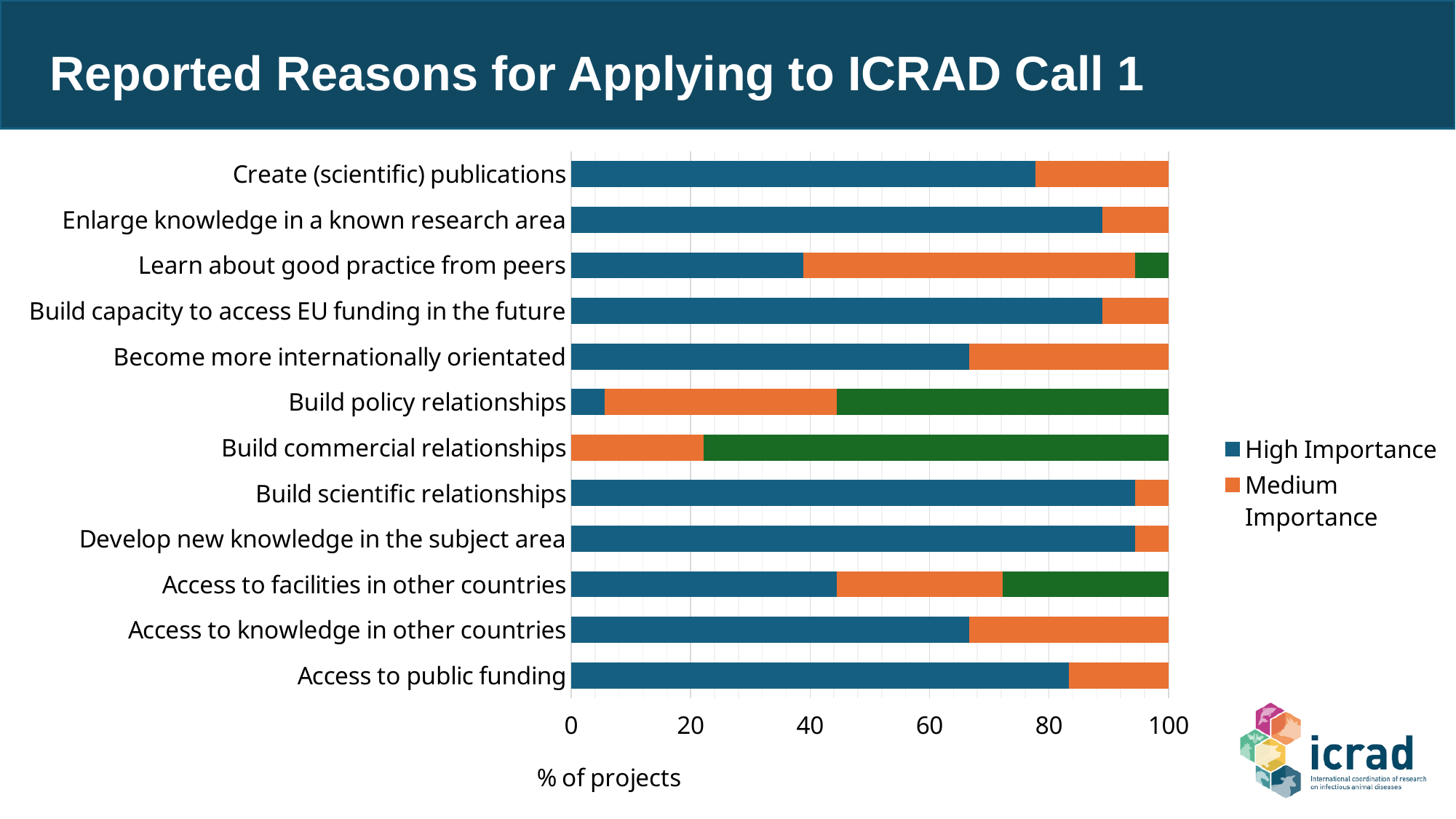
How many series does the legend list? 2 What is the total of the stacked bar for 'Build policy relationships'? 100 Is the High Importance value for 'Learn about good practice from peers' greater or less than 60? less Is the High Importance value for 'Become more internationally orientated' greater or less than 80? less Is the High Importance value for 'Build policy relationships' greater or less than 20? less What kind of chart is shown on the slide? Stacked bar chart Which has the larger Medium Importance value: 'Learn about good practice from peers' or 'Enlarge knowledge in a known research area'? Learn about good practice from peers Which has the larger High Importance value: 'Create (scientific) publications' or 'Learn about good practice from peers'? Create (scientific) publications Which reason has the lowest High Importance value? Build commercial relationships How many reasons (categories) are listed on the chart? 12 What is the x-axis title of the chart? % of projects